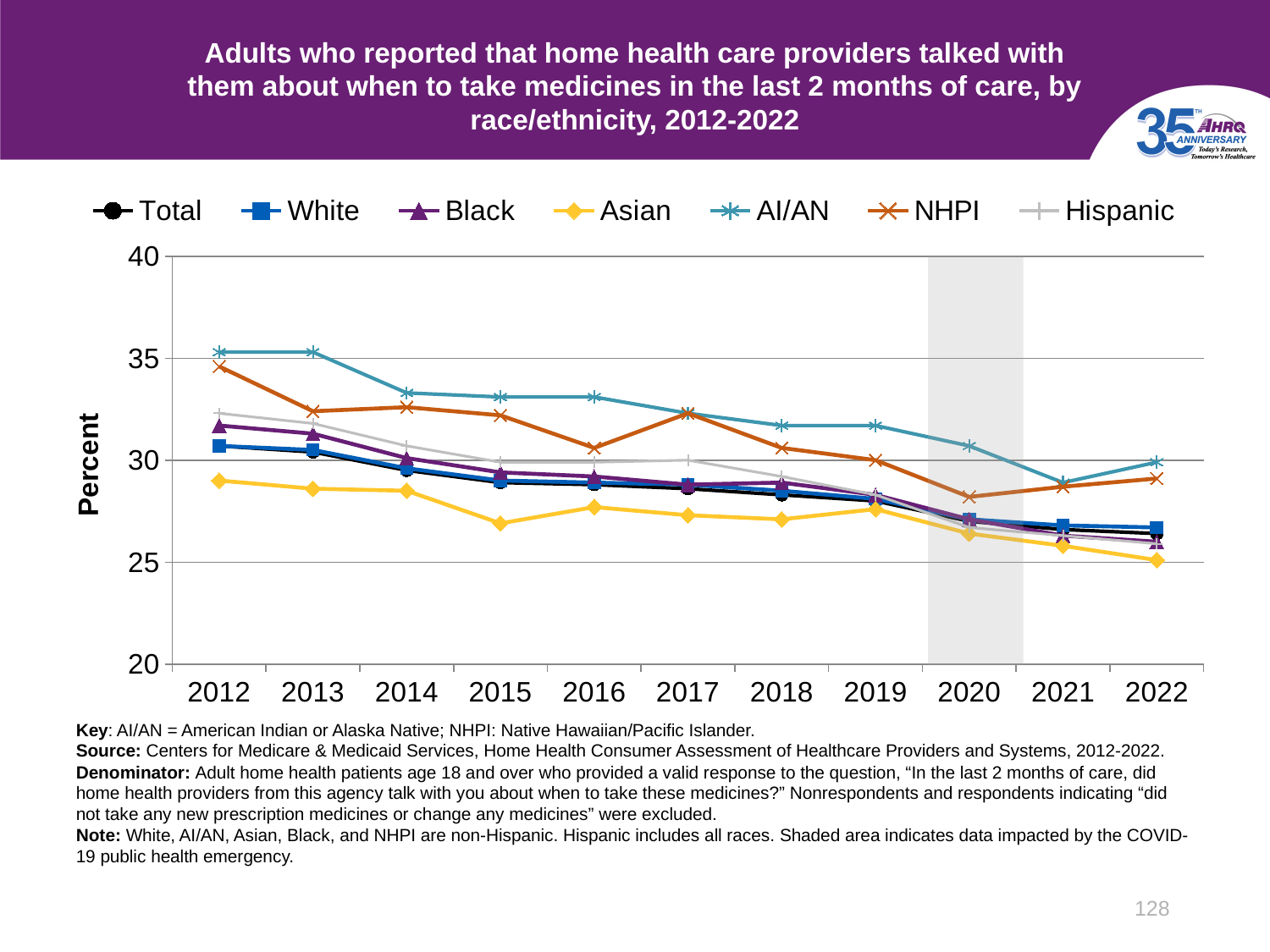
Which race/ethnicity group has the highest value in 2012? AI/AN How many years are plotted along the x axis? 11 Which race/ethnicity group has the lowest value in 2012? Asian Is the value for AI/AN in 2012 greater or less than 30? greater Do the values for the Total series generally rise or fall from 2012 to 2022? Fall Which race/ethnicity group has the highest value in 2022? AI/AN How many series does the legend list? 7 In 2016, which is larger, the value for NHPI or the value for Asian? NHPI Which race/ethnicity group has the lowest value in 2022? Asian What kind of chart is shown on the slide? Line chart Is the value for Asian in 2015 greater or less than 30? less According to the note, what does the shaded area on the chart indicate? Data impacted by the COVID-19 public health emergency